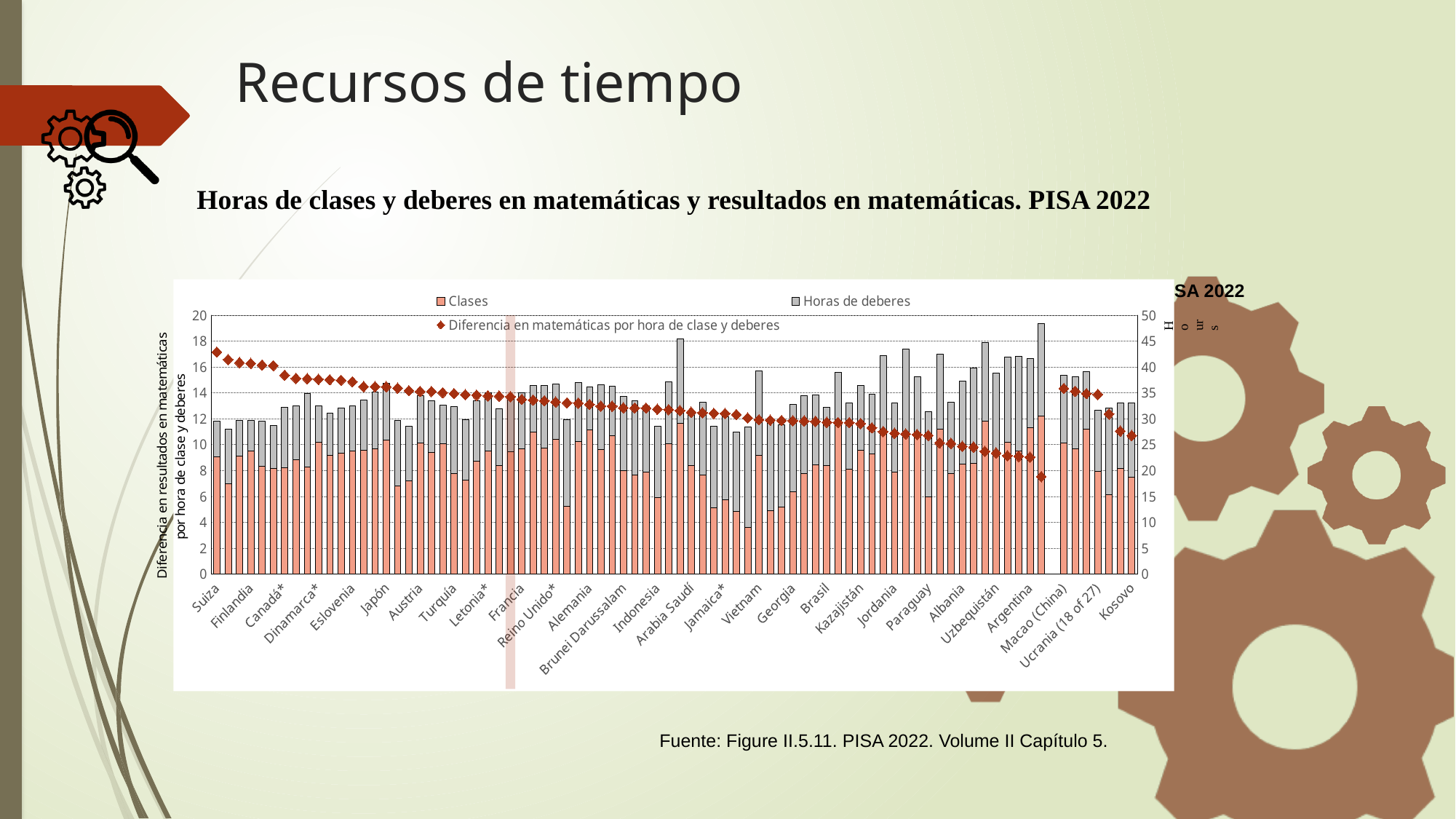
Which country has a higher 'Diferencia en matemáticas por hora de clase y deberes' value, Suiza or Kosovo? Suiza Which country is the first category on the left of the x axis? Suiza Is the 'Diferencia en matemáticas por hora de clase y deberes' value for Argentina greater or less than 10 on the left axis? less What kind of chart is shown on the slide? Stacked bar chart with a diamond marker series Does the 'Diferencia en matemáticas por hora de clase y deberes' series rise or fall from left to right across the countries? Fall Is the 'Diferencia en matemáticas por hora de clase y deberes' value for Suiza greater or less than 16 on the left axis? greater How many series does the chart legend list? 3 Is the 'Diferencia en matemáticas por hora de clase y deberes' value for Kosovo greater or less than 12 on the left axis? less Which legend entry is shown in grey? Horas de deberes What is the maximum value shown on the right-hand axis of the chart? 50